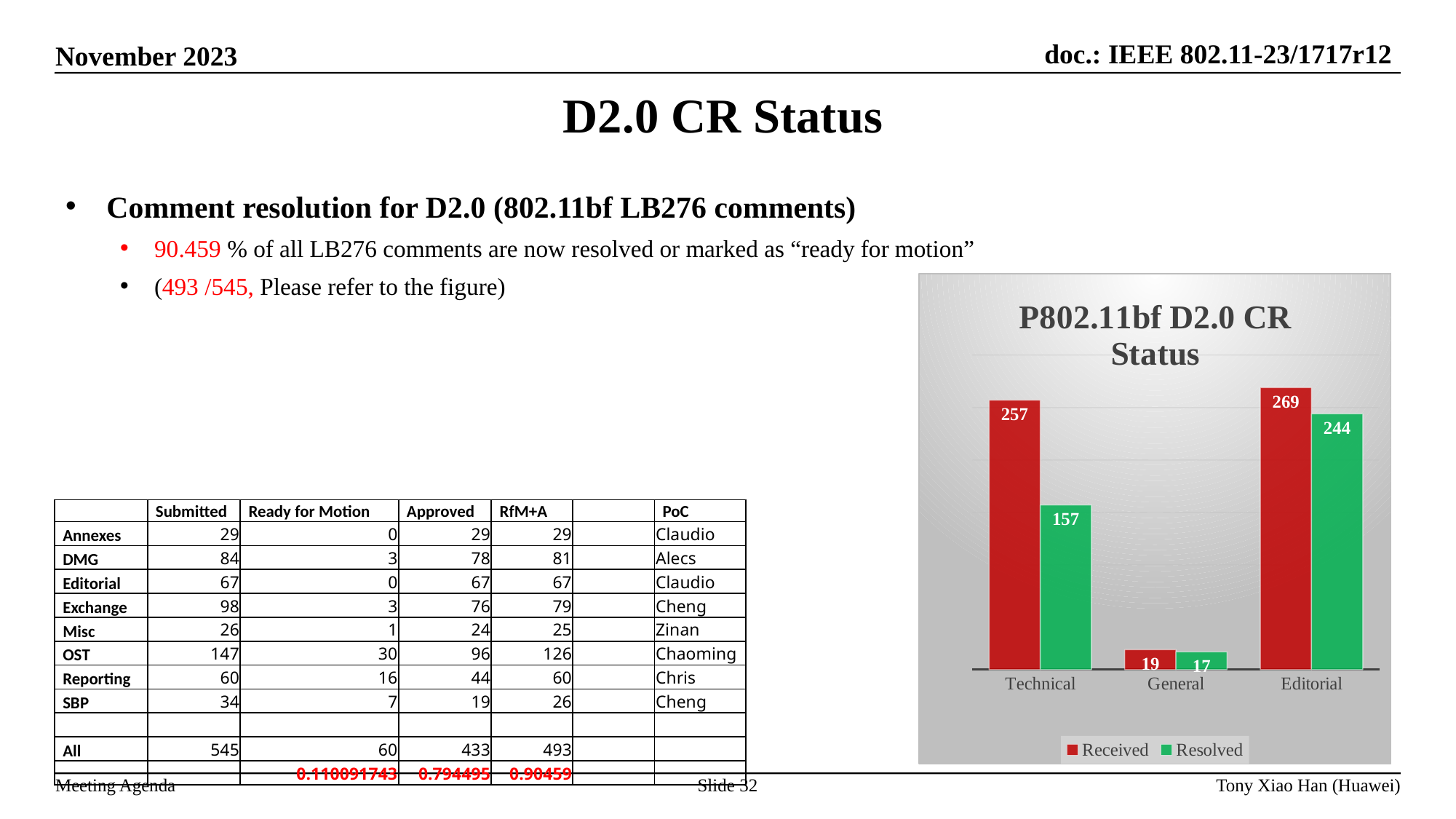
What is the difference between Received and Resolved for Technical? 100 What is the Received value for Technical? 257 What is the Resolved value for Editorial? 244 Which is larger, the Received value for Technical or the Received value for Editorial? Editorial Which category has the highest Received value? Editorial How many series does the chart legend list? 2 Which category has the lowest Resolved value? General How many categories are shown on the x axis of the chart? 3 What is the Resolved value for General? 17 What type of chart is shown on the slide? bar chart Which colour represents the Resolved series in the chart? green What is the title of the chart? P802.11bf D2.0 CR Status